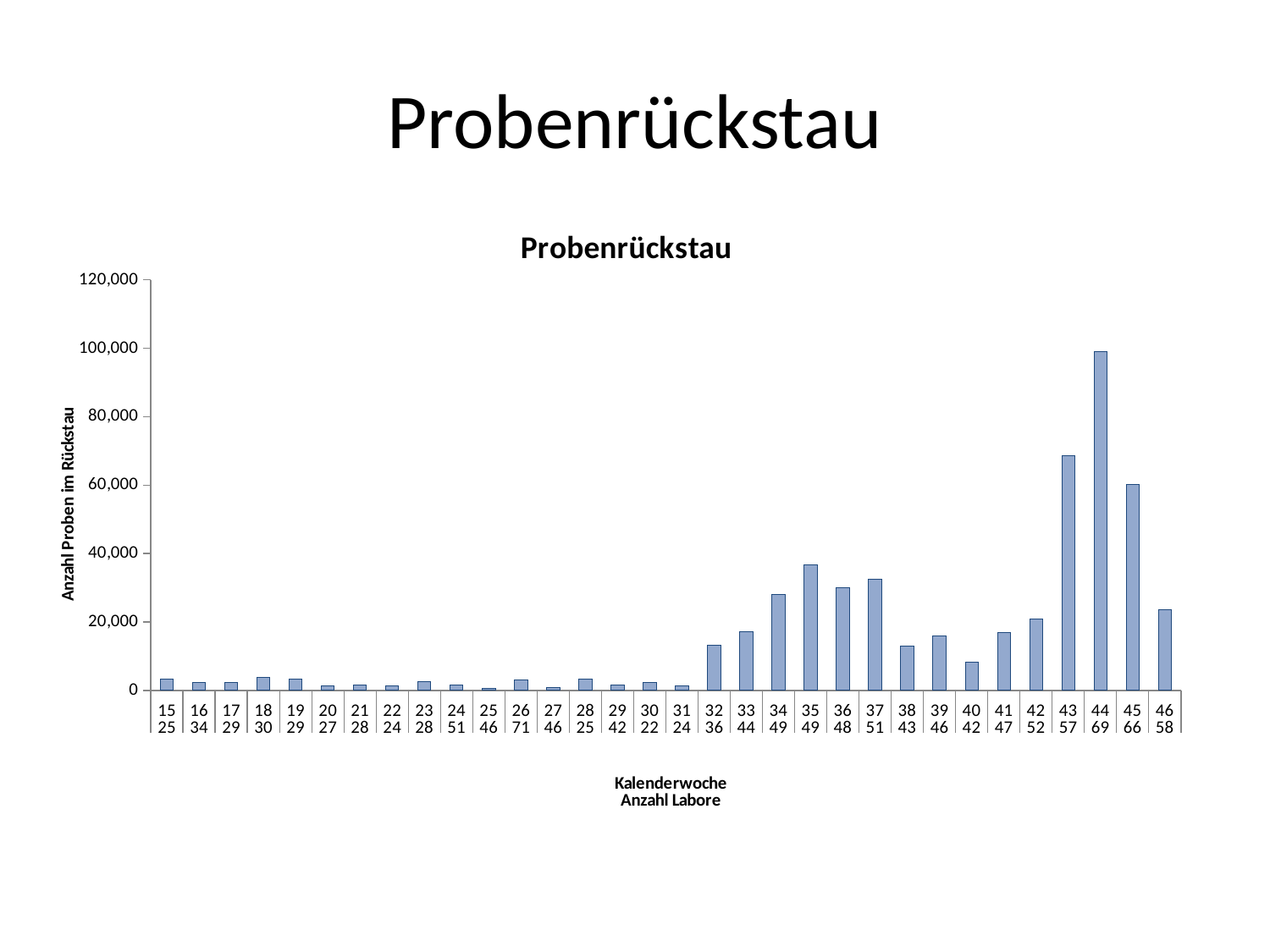
What kind of chart is shown on the slide? bar chart Which has the larger Probenrückstau, Kalenderwoche 35 or Kalenderwoche 36? 35 Which Kalenderwoche has the highest Probenrückstau? 44 How many calendar weeks (Kalenderwoche) are plotted on the x axis? 32 Which has the larger Probenrückstau, Kalenderwoche 43 or Kalenderwoche 45? 43 What is the title of the vertical axis? Anzahl Proben im Rückstau Is the value for Kalenderwoche 35 greater or less than 40,000? less Is the value for Kalenderwoche 40 greater or less than 20,000? less Is the value for Kalenderwoche 43 greater or less than 60,000? greater Do the values rise or fall from Kalenderwoche 41 to Kalenderwoche 44? rise